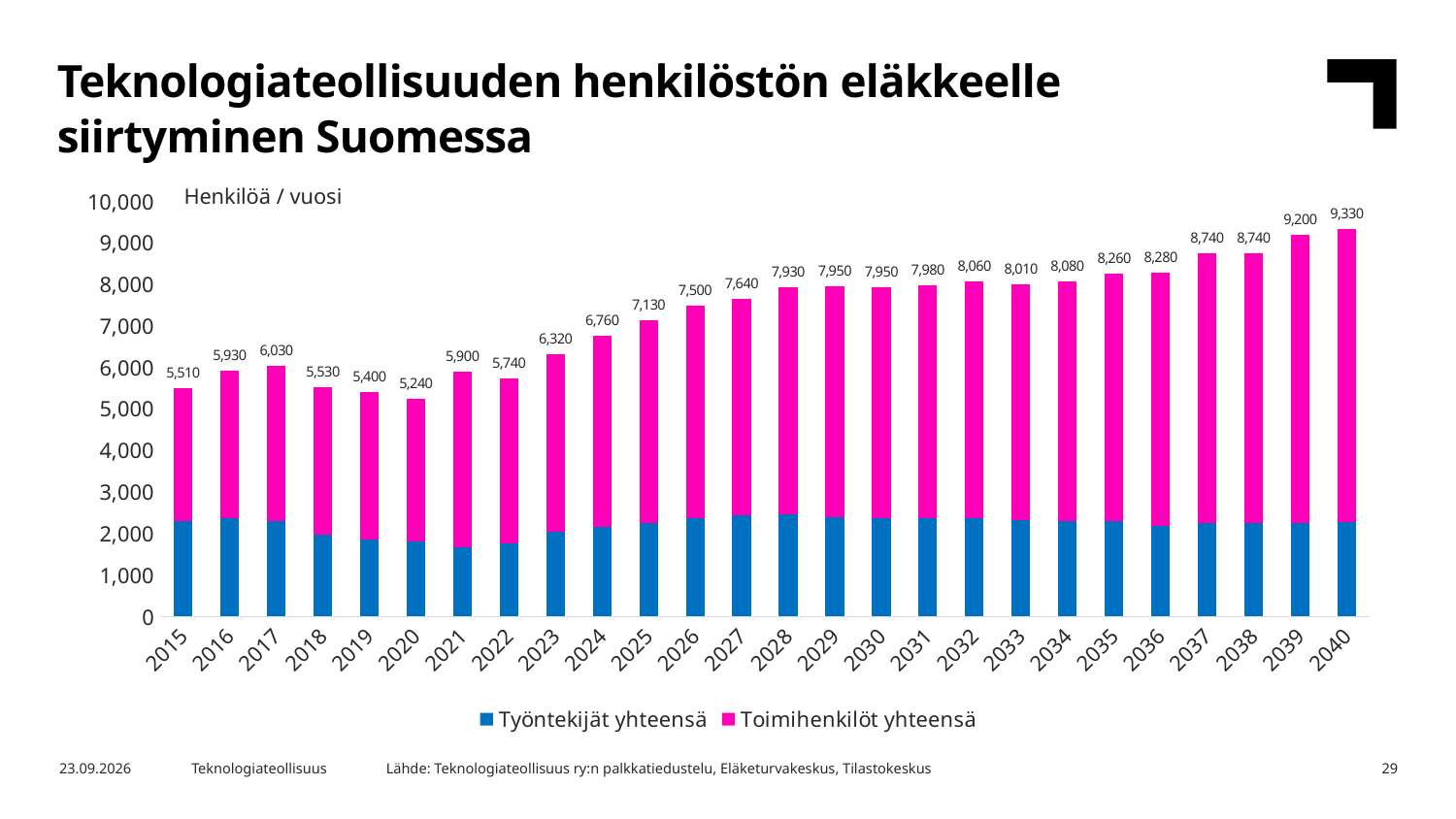
Which year has the highest total? 2040 Is the value for Työntekijät yhteensä in 2015 greater or less than 3,000? less What is the difference between the totals for 2040 and 2015? 3,820 What is the total labelled for 2040? 9,330 Which year has the lowest total? 2020 Which total is larger, 2017 or 2023? 2023 What is the total labelled for 2020? 5,240 Is the value for Toimihenkilöt yhteensä in 2040 greater or less than 6,000? greater What kind of chart is shown? Stacked bar chart How many series does the legend list? 2 What unit label is shown at the top of the chart? Henkilöä / vuosi How many years are shown on the x axis? 26